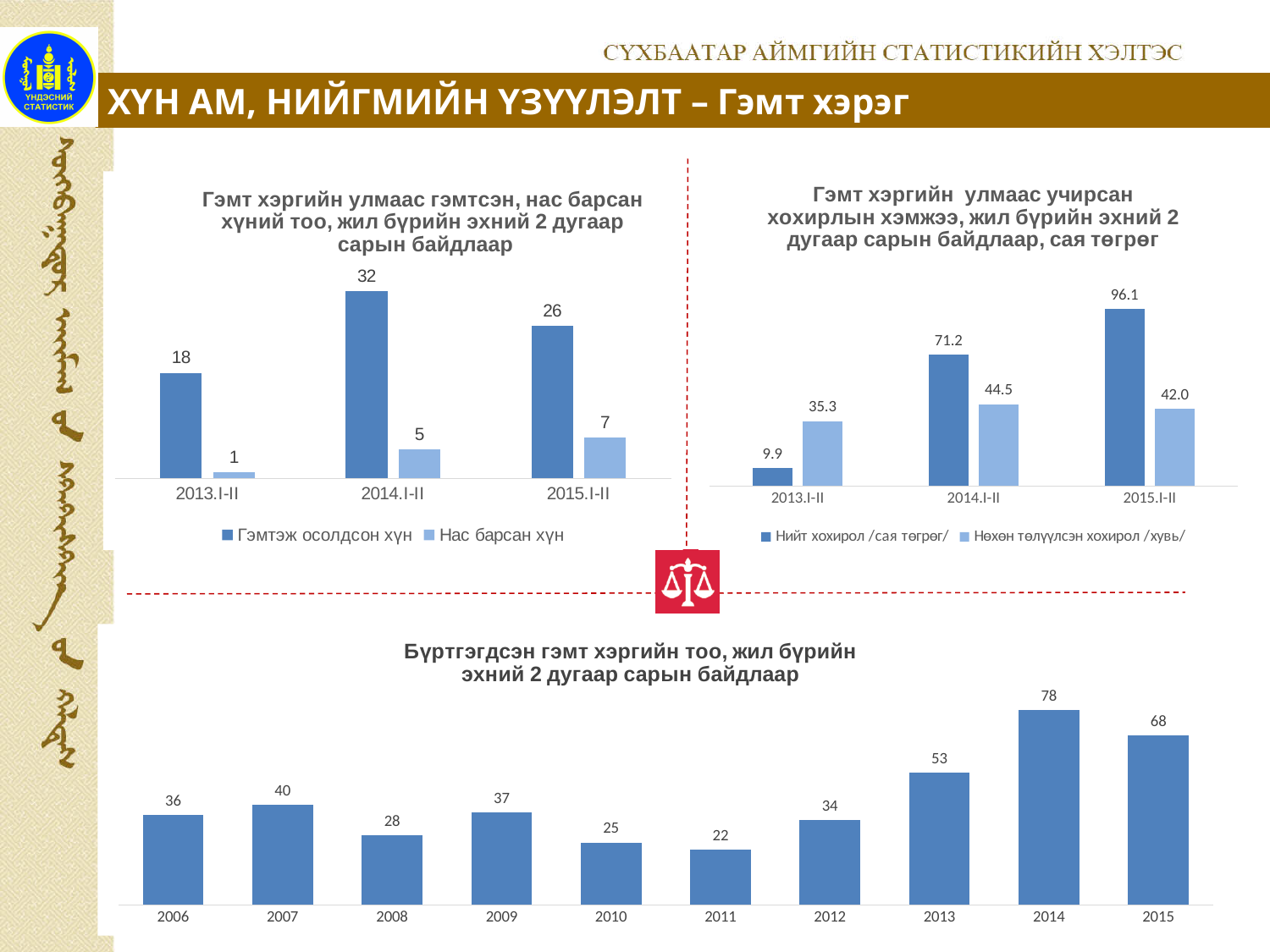
In the bottom chart (Бүртгэгдсэн гэмт хэргийн тоо), which year has the highest value? 2014 In the bottom chart (Бүртгэгдсэн гэмт хэргийн тоо), which year has the lowest value? 2011 In the top-right chart (Гэмт хэргийн улмаас учирсан хохирлын хэмжээ), what is the value for Нийт хохирол in 2015.I-II? 96.1 In the top-left chart (Гэмт хэргийн улмаас гэмтсэн, нас барсан хүний тоо), what is the value for Гэмтэж осолдсон хүн in 2014.I-II? 32 In the top-right chart (Гэмт хэргийн улмаас учирсан хохирлын хэмжээ), does the Нийт хохирол series rise or fall from 2013.I-II to 2015.I-II? rise In the bottom chart (Бүртгэгдсэн гэмт хэргийн тоо), what is the value for 2014? 78 In the top-left chart (Гэмт хэргийн улмаас гэмтсэн, нас барсан хүний тоо), how many series does the legend list? 2 What kind of chart is the bottom chart (Бүртгэгдсэн гэмт хэргийн тоо)? bar chart In the top-left chart (Гэмт хэргийн улмаас гэмтсэн, нас барсан хүний тоо), what is the value for Нас барсан хүн in 2015.I-II? 7 How many years are shown on the x axis of the bottom chart (Бүртгэгдсэн гэмт хэргийн тоо)? 10 In the top-right chart (Гэмт хэргийн улмаас учирсан хохирлын хэмжээ), what is the value for Нөхөн төлүүлсэн хохирол in 2013.I-II? 35.3 In the bottom chart (Бүртгэгдсэн гэмт хэргийн тоо), what is the difference between the values for 2014 and 2015? 10